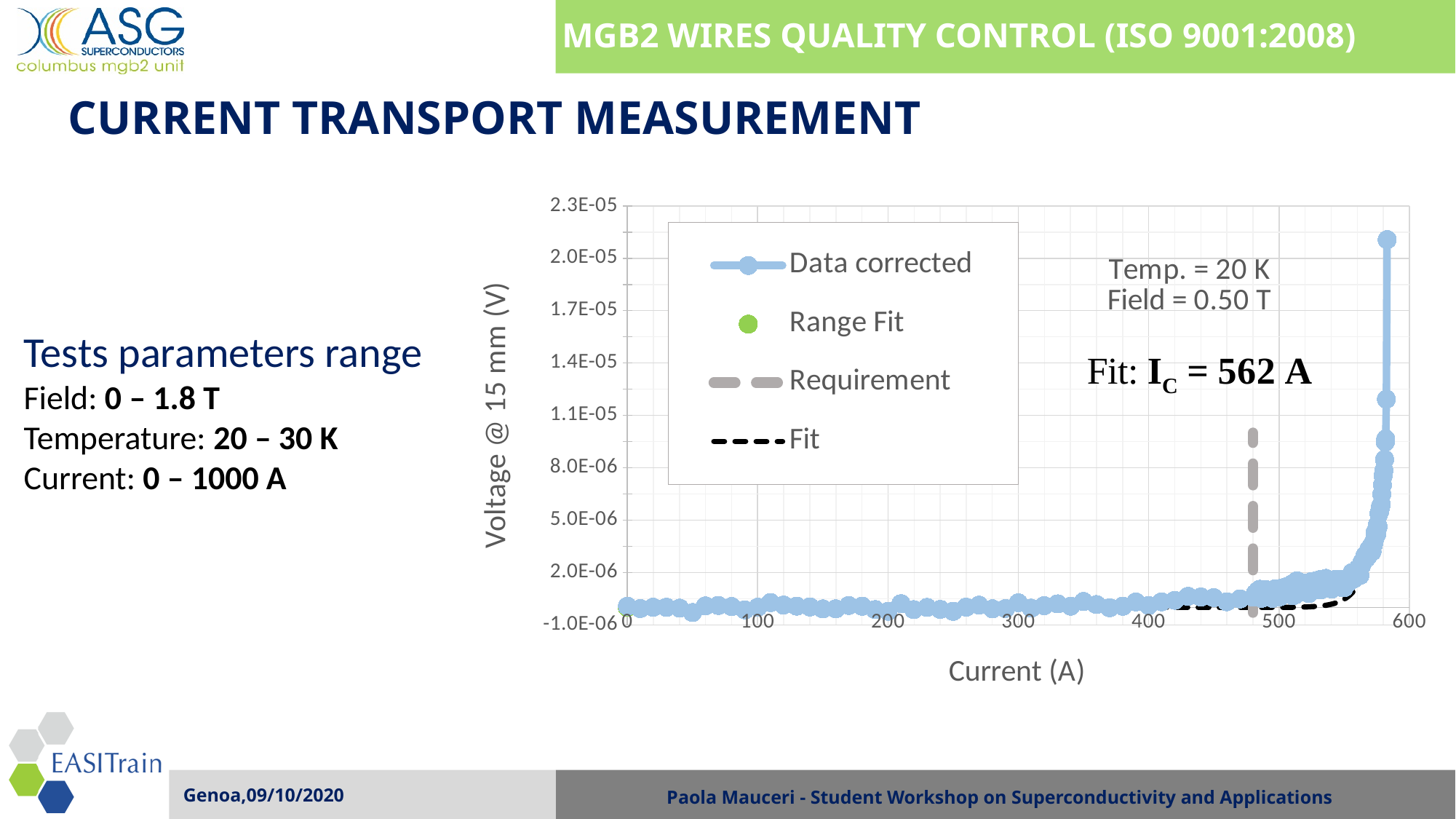
Is the current at which the 'Requirement' dashed line is drawn greater or less than 400 A? greater Is the highest 'Data corrected' voltage point greater or less than 1.7E-05 V? greater What magnetic field is stated in the chart annotation? 0.50 T What is the label of the x axis of the chart? Current (A) What critical current value does the fit annotation on the chart give? Ic = 562 A Which series in the legend is drawn as a black dashed line? Fit How many series does the chart legend list? 4 Is the 'Data corrected' voltage at 300 A greater or less than 2.0E-06 V? less At what temperature was the measurement shown in the chart taken, according to the annotation? 20 K Does the voltage of the 'Data corrected' series rise or fall as the current increases toward 600 A? rise What is the label of the y axis of the chart? Voltage @ 15 mm (V) What kind of chart is shown on the slide? Scatter (line) chart